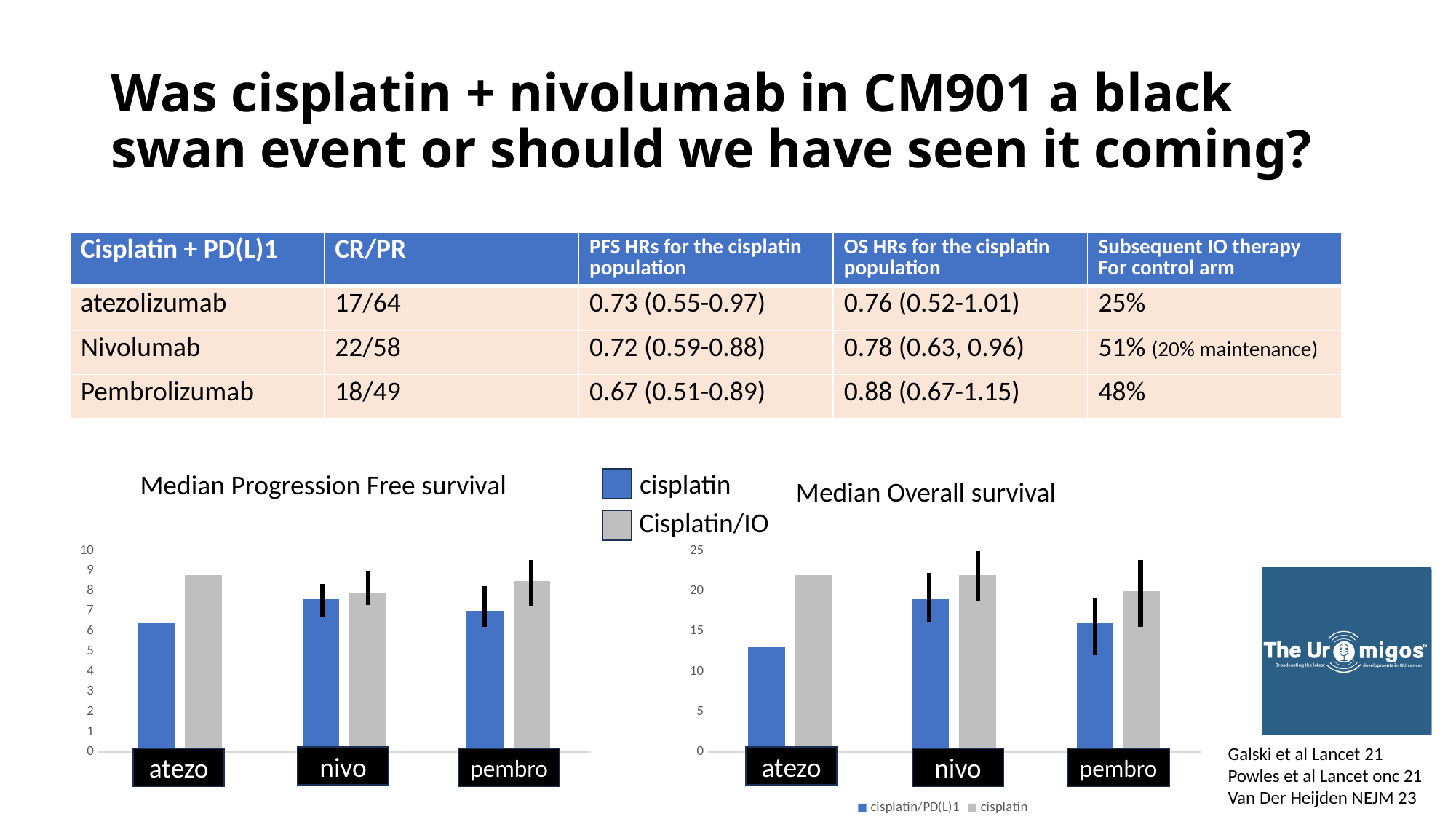
In the Median Progression Free survival chart, for atezo, which bar is taller, the blue bar or the grey bar? the grey bar In the Median Progression Free survival chart, is the blue bar for atezo greater or less than 7? less How many categories are shown on the x axis of the Median Overall survival chart? 3 In the Median Overall survival chart, which category has the lowest blue bar? atezo In the Median Progression Free survival chart, is the blue bar for nivo greater or less than 7? greater In the Median Overall survival chart, is the blue bar for atezo greater or less than 15? less What kind of chart is the Median Progression Free survival chart? bar chart In the Median Overall survival chart, which category has the highest blue bar? nivo How many series does the legend between the two charts list? 2